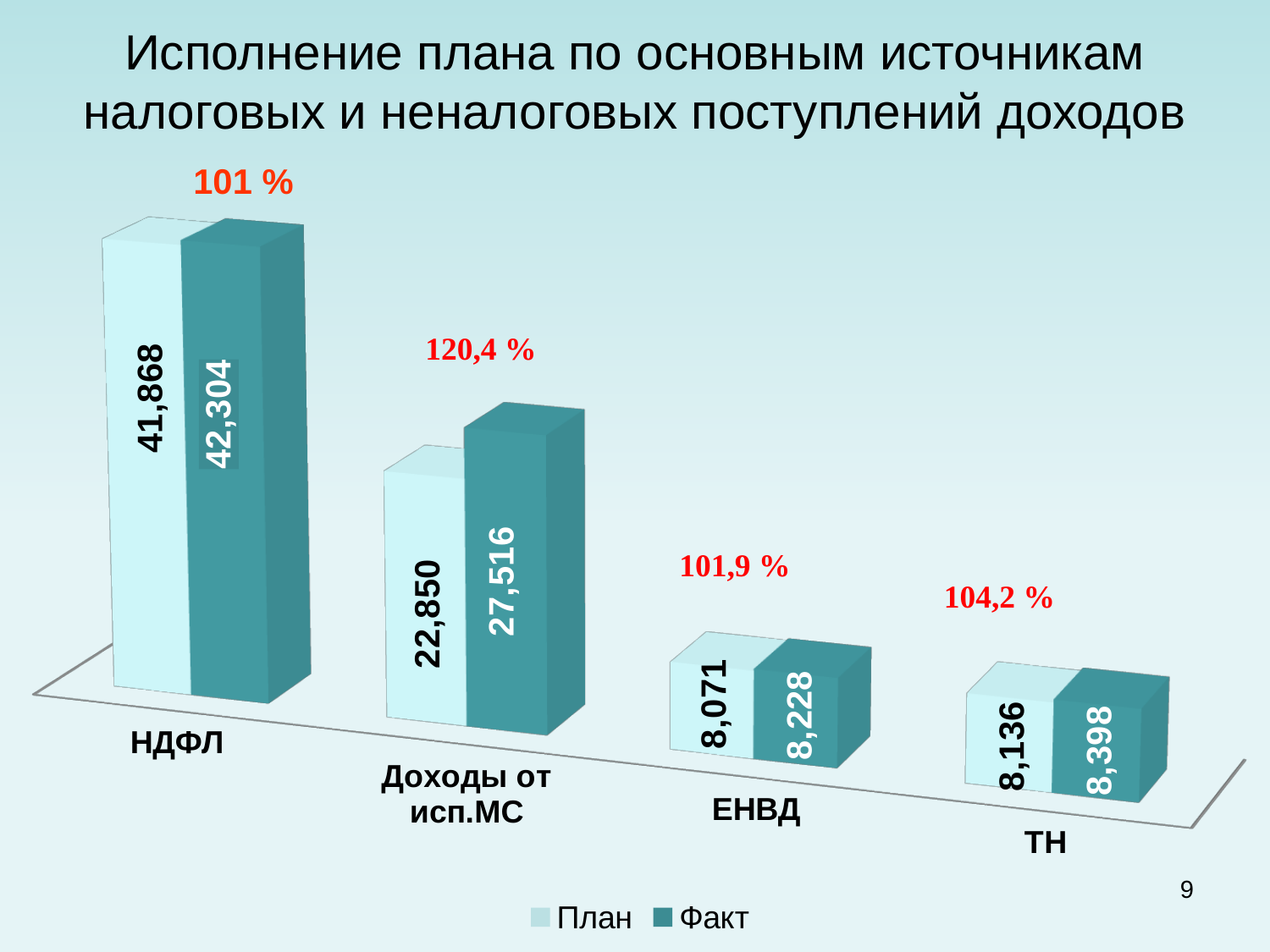
How many series does the legend list? 2 What is the План value for ТН? 8,136 What is the Факт (actual) value for Доходы от исп.МС? 27,516 What is the Факт value for ЕНВД? 8,228 Which is larger for ТН, the План value or the Факт value? Факт What is the difference between the Факт and План values for Доходы от исп.МС? 4,666 Which category has the lowest План value? ЕНВД What is the План (plan) value for НДФЛ? 41,868 What plan execution percentage is shown above the Доходы от исп.МС bars? 120,4 % Which category has the highest Факт value? НДФЛ How many categories are shown on the x axis? 4 What is the difference between the Факт and План values for НДФЛ? 436